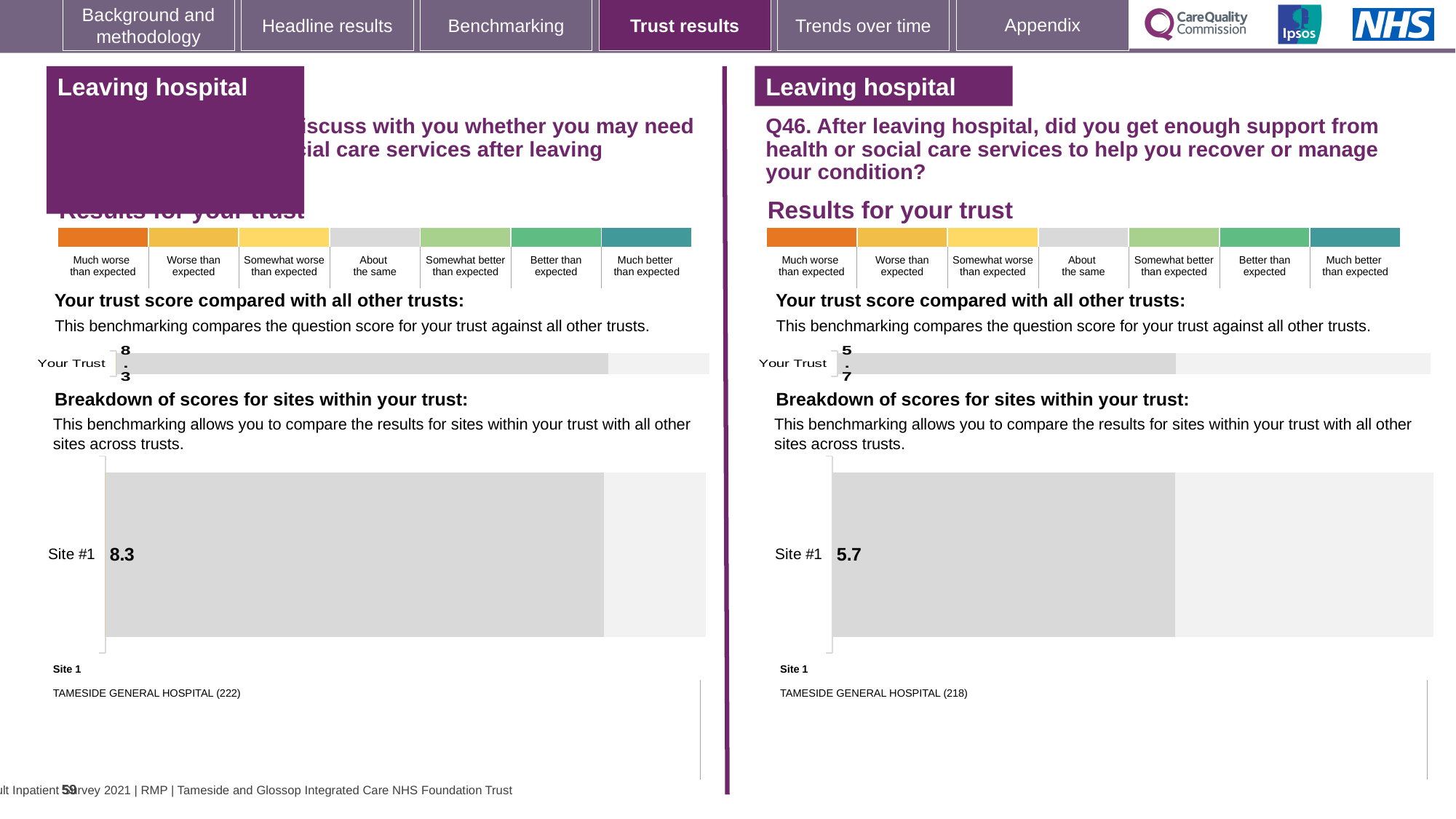
On the left-hand chart, what is the score shown for Your Trust? 8.3 On the right-hand chart for Q46, what is the score shown for Your Trust? 5.7 Is the Site #1 score on the right-hand Q46 chart greater or less than the Site #1 score on the left-hand chart? less What kind of chart is used to show the Your Trust score on each side of the slide? bar chart How many sites are shown in the left-hand breakdown of scores for sites chart? 1 Which hospital is listed as Site 1 beneath the left-hand breakdown chart? TAMESIDE GENERAL HOSPITAL What is the difference between the Your Trust score on the left-hand chart and the Your Trust score on the right-hand Q46 chart? 2.6 Which is larger: the Your Trust score on the left-hand chart or the Your Trust score on the right-hand Q46 chart? the left-hand chart (8.3) How many sites are shown in the right-hand breakdown of scores for sites chart (Q46)? 1 What is the category label on the bar in the breakdown of scores chart on the right-hand side? Site #1 In the left-hand breakdown of scores for sites chart, what is the score for Site #1? 8.3 In the right-hand breakdown of scores for sites chart (Q46), what is the score for Site #1? 5.7